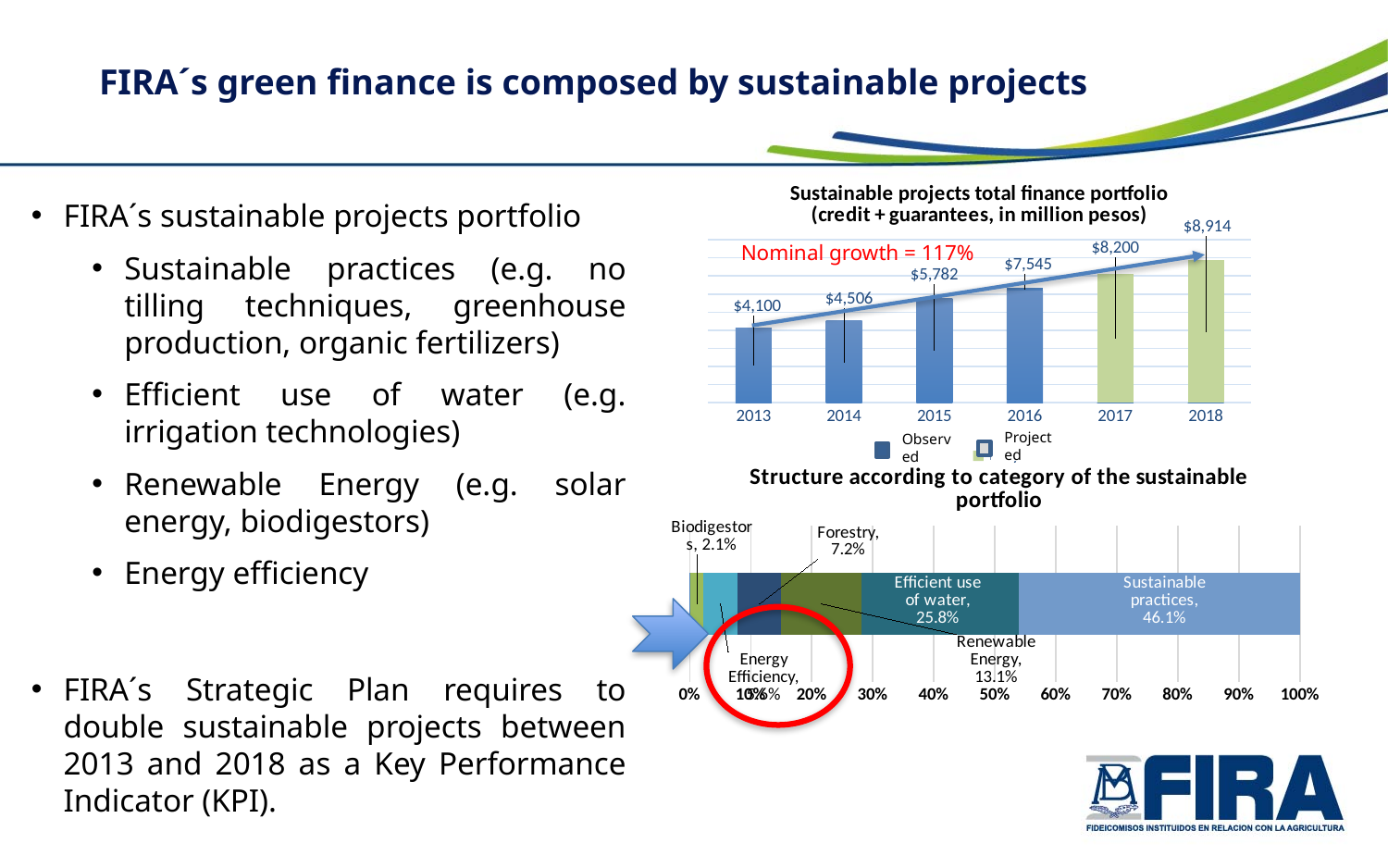
In the 'Sustainable projects total finance portfolio' chart, which year has the lowest value? 2013 In the 'Sustainable projects total finance portfolio' chart, what is the value for 2018? $8,914 In the 'Structure according to category of the sustainable portfolio' chart, what is the share for Renewable Energy? 13.1% In the 'Sustainable projects total finance portfolio' chart, what is the difference between the 2018 and 2013 values? $4,814 In the 'Structure according to category of the sustainable portfolio' chart, which is larger, Efficient use of water or Forestry? Efficient use of water In the 'Structure according to category of the sustainable portfolio' chart, what is the share for Sustainable practices? 46.1% How many series does the legend of the 'Sustainable projects total finance portfolio' chart list? 2 What kind of chart is the 'Sustainable projects total finance portfolio' chart? bar chart In the 'Sustainable projects total finance portfolio' chart, what is the value for 2016? $7,545 In the 'Sustainable projects total finance portfolio' chart, do the values rise or fall from 2013 to 2018? rise In the 'Sustainable projects total finance portfolio' chart, which year has the highest value? 2018 In the 'Sustainable projects total finance portfolio' chart, what is the value for 2013? $4,100